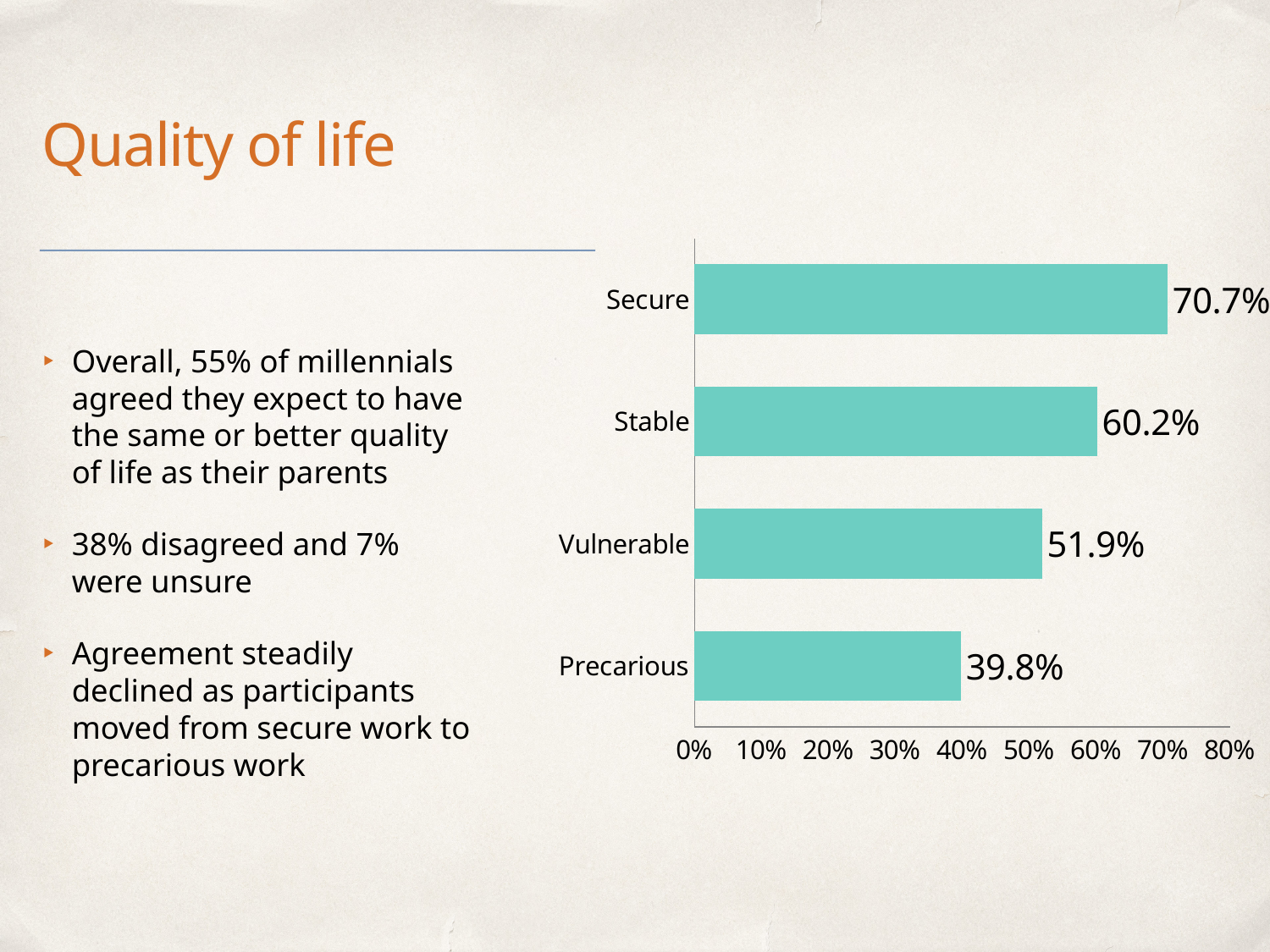
What is the highest value shown on the chart's axis? 80% What kind of chart is shown on the slide? bar chart Which category has the highest value? Secure How many categories are shown in the chart? 4 Is the value for Stable greater or less than 50%? greater What is the difference between the values for Secure and Precarious? 30.9% What is the value for Secure? 70.7% What is the value for Vulnerable? 51.9% Which category has the lowest value? Precarious Which is larger, the value for Stable or the value for Vulnerable? Stable What is the difference between the values for Stable and Vulnerable? 8.3% What is the value for Precarious? 39.8%